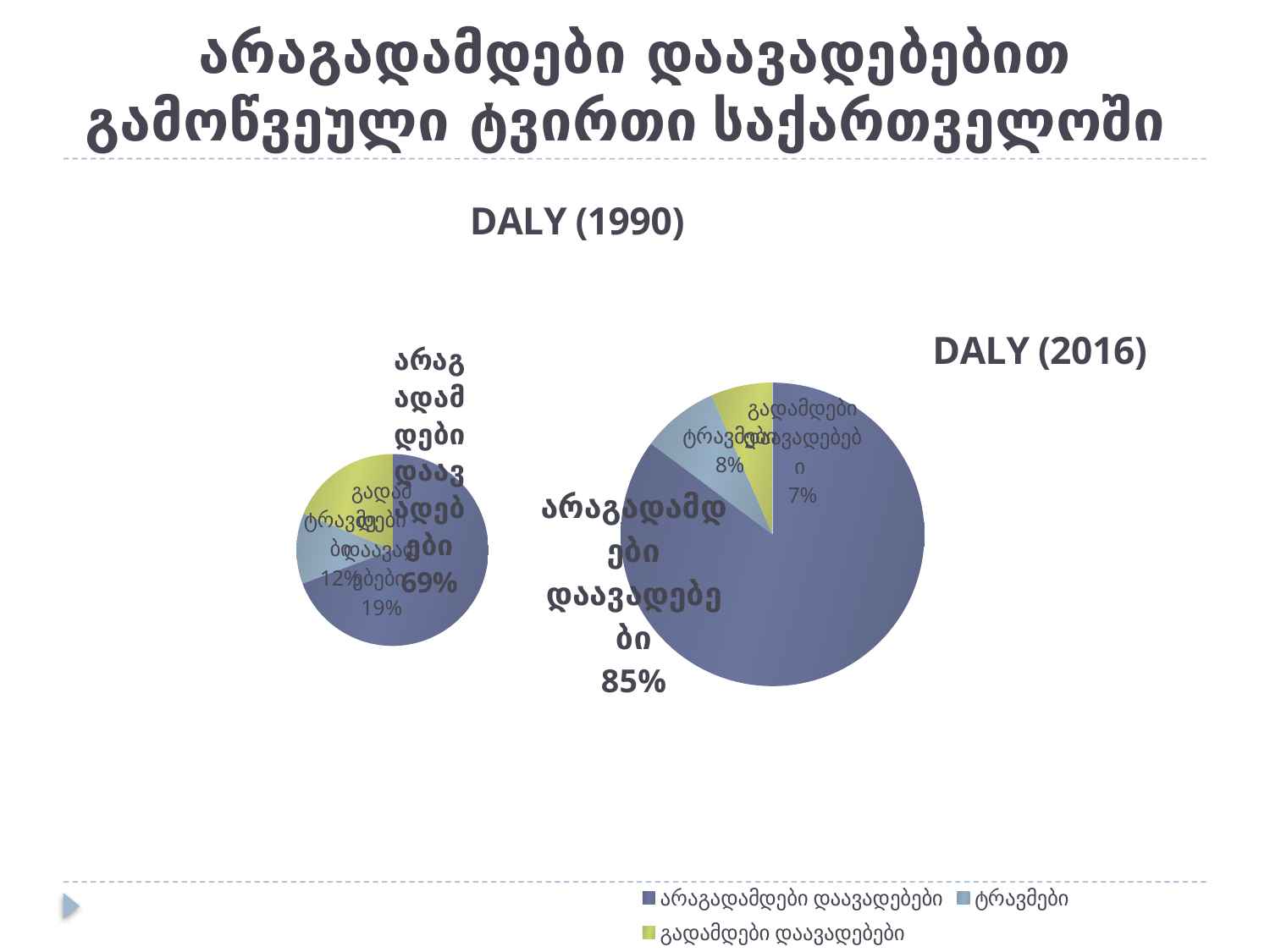
In the DALY (2016) chart, what share is shown for არაგადამდები დაავადებები? 85% In the DALY (1990) chart, what share is shown for არაგადამდები დაავადებები? 69% In the DALY (2016) chart, what share is shown for გადამდები დაავადებები? 7% What is the difference between the share of არაგადამდები დაავადებები in the DALY (2016) chart and in the DALY (1990) chart? 16% In the DALY (1990) chart, which category has the smallest slice? ტრავმები In the DALY (2016) chart, what share is shown for ტრავმები? 8% In the DALY (2016) chart, which category has the largest slice? არაგადამდები დაავადებები In the DALY (1990) chart, which is larger: the share of გადამდები დაავადებები or the share of ტრავმები? გადამდები დაავადებები In the DALY (1990) chart, what share is shown for გადამდები დაავადებები? 19% In the DALY (1990) chart, what share is shown for ტრავმები? 12% How many categories does the legend at the bottom of the slide list? 3 What type of chart is the DALY (2016) chart? Pie chart